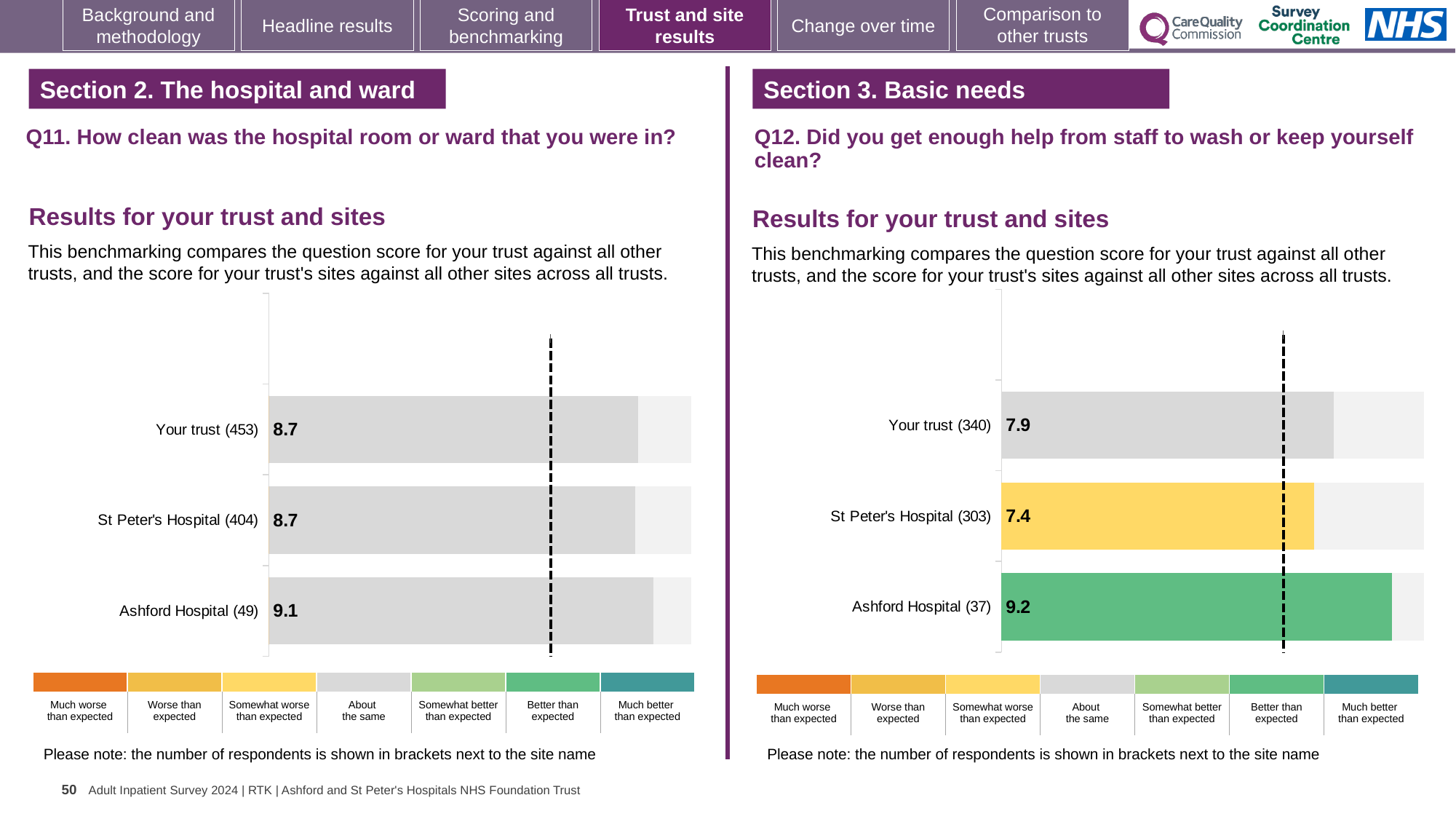
In the Q11 chart, which site has the highest score? Ashford Hospital In the Q12 chart, which has the larger score: Your trust or Ashford Hospital? Ashford Hospital In the Q12 chart, what is the difference between the scores for Ashford Hospital and St Peter's Hospital? 1.8 In the Q12 chart (Did you get enough help from staff to wash or keep yourself clean), what is the score for Your trust? 7.9 In the Q12 chart, which site or trust has the highest score? Ashford Hospital In the Q12 chart (Did you get enough help from staff to wash or keep yourself clean), what is the score for St Peter's Hospital? 7.4 In the Q12 chart, which site or trust has the lowest score? St Peter's Hospital In the Q11 chart (How clean was the hospital room or ward), what is the score for Ashford Hospital? 9.1 How many bars are plotted in the Q11 chart? 3 What type of chart is used for the Q12 results? Bar chart In the Q11 chart (How clean was the hospital room or ward), what is the score for Your trust? 8.7 In the Q11 chart, what is the difference between the scores for Ashford Hospital and Your trust? 0.4